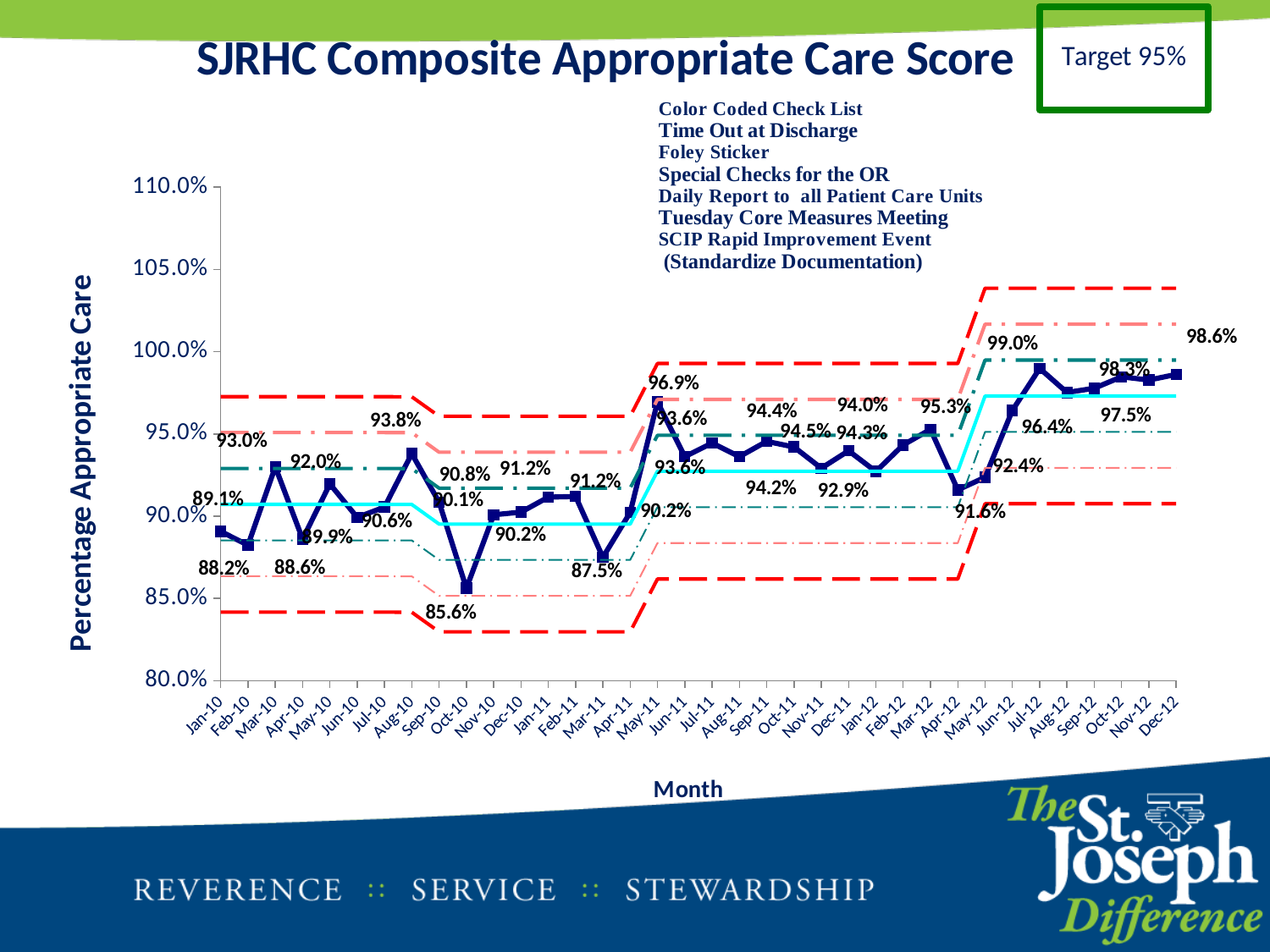
Which month has the highest composite appropriate care score? Jul-12 What is the highest value plotted on the chart? 99.0% Is the value for Dec-12 greater or less than 95.0%? greater Which is larger, the value for Oct-10 or the value for May-11? May-11 What type of chart is shown on the slide? Line chart What is the value for Dec-12? 98.6% What is the value for Mar-11? 87.5% What is the title of the chart? SJRHC Composite Appropriate Care Score What is the difference between the highest value (Jul-12) and the lowest value (Oct-10)? 13.4 percentage points Which month has the lowest composite appropriate care score? Oct-10 What is the value for Oct-10? 85.6% What is the target value shown on the slide? 95%